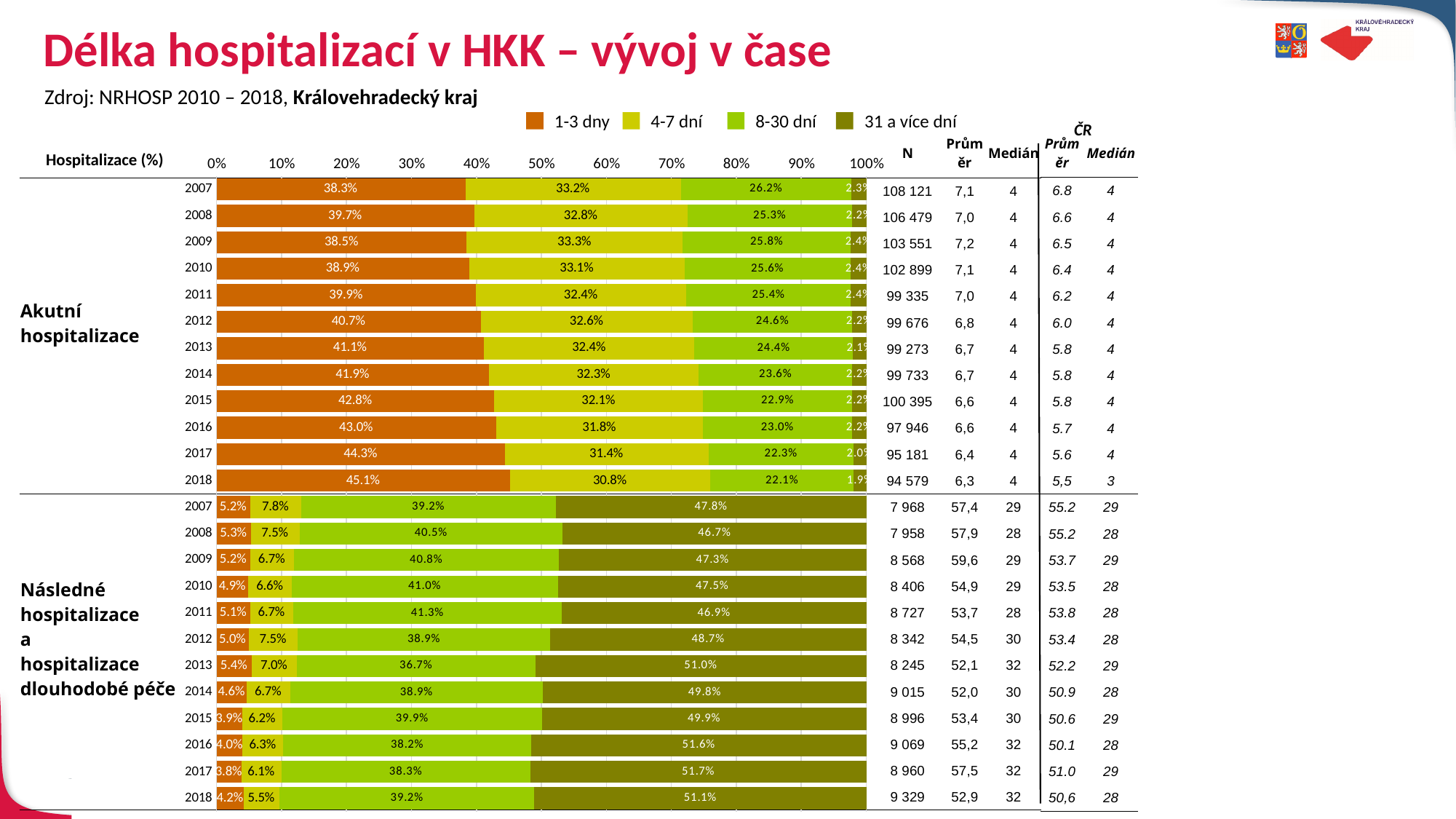
How many series does the legend list? 4 In the Akutní hospitalizace section, which year has the highest share of 1-3 dny? 2018 In the Akutní hospitalizace section, what is the difference between the 1-3 dny share in 2018 and in 2007? 6.8 percentage points In the Následné hospitalizace section, what is the share of 1-3 dny in 2010? 4.9% What kind of chart is shown on the slide? Stacked bar chart In the Akutní hospitalizace section for 2012, which is larger: the 4-7 dní share or the 8-30 dní share? 4-7 dní How many years are shown in the Akutní hospitalizace section? 12 In the Akutní hospitalizace section, which year has the lowest share of 1-3 dny? 2007 In the Akutní hospitalizace section, what is the share of 1-3 dny in 2018? 45.1% In the Následné hospitalizace section, what is the share of 31 a více dní in 2013? 51.0% In the Akutní hospitalizace section, does the share of 1-3 dny rise or fall from 2007 to 2018? Rises Which legend entry is shown in dark olive green? 31 a více dní